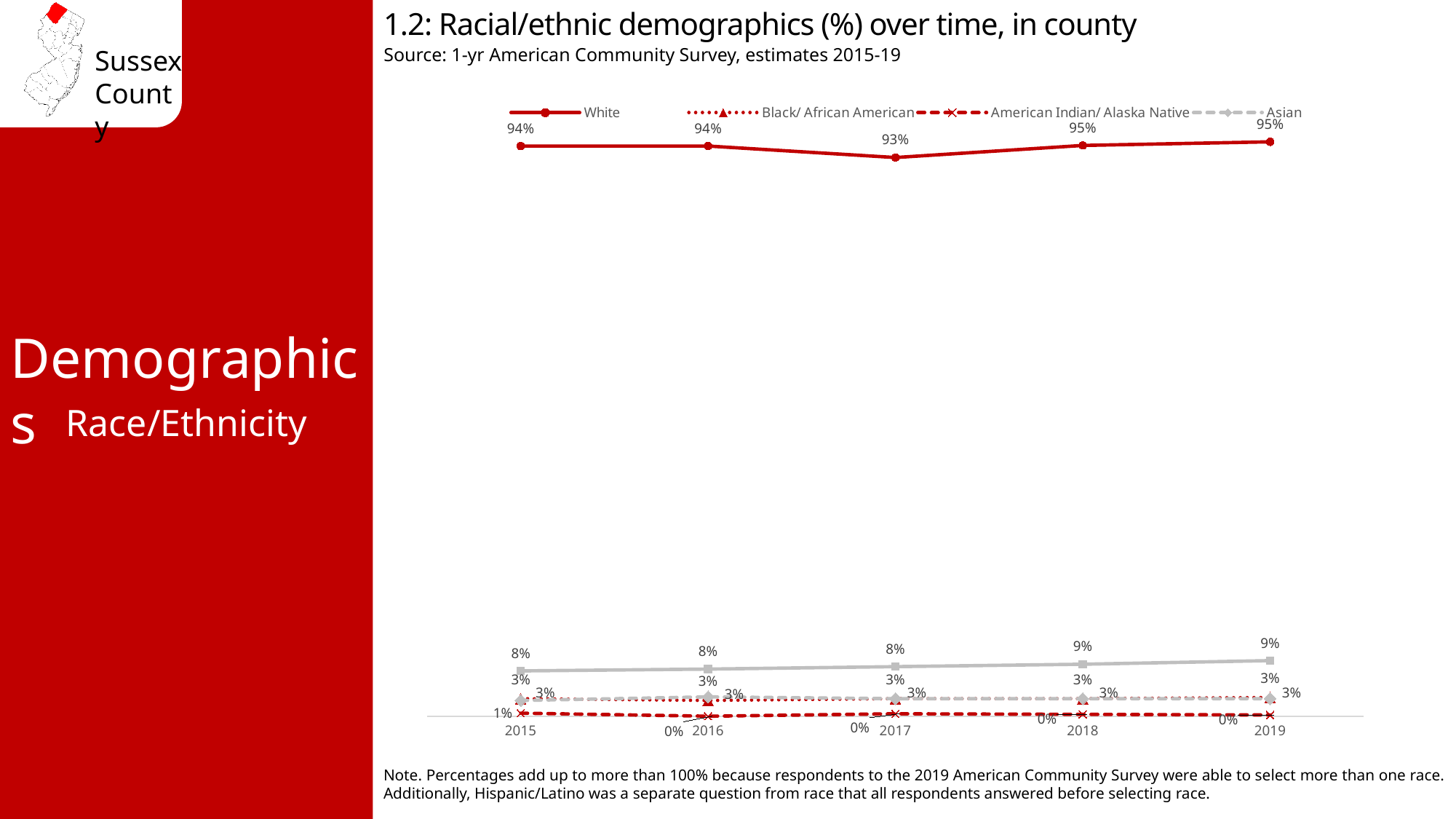
What is the value for American Indian/ Alaska Native in 2019? 0% How many years are shown on the x axis? 5 What kind of chart is shown on the slide? line chart What is the title of the chart? 1.2: Racial/ethnic demographics (%) over time, in county What is the value for White in 2017? 93% What is the value for Black/ African American in 2018? 3% What is the value for White in 2019? 95% Does the White line rise or fall from 2017 to 2019? rise What is the difference between the White value in 2019 and in 2017? 2 percentage points Which is larger, the White value in 2015 or in 2017? 2015 In which year is the value for White lowest? 2017 What is the value for American Indian/ Alaska Native in 2015? 1%